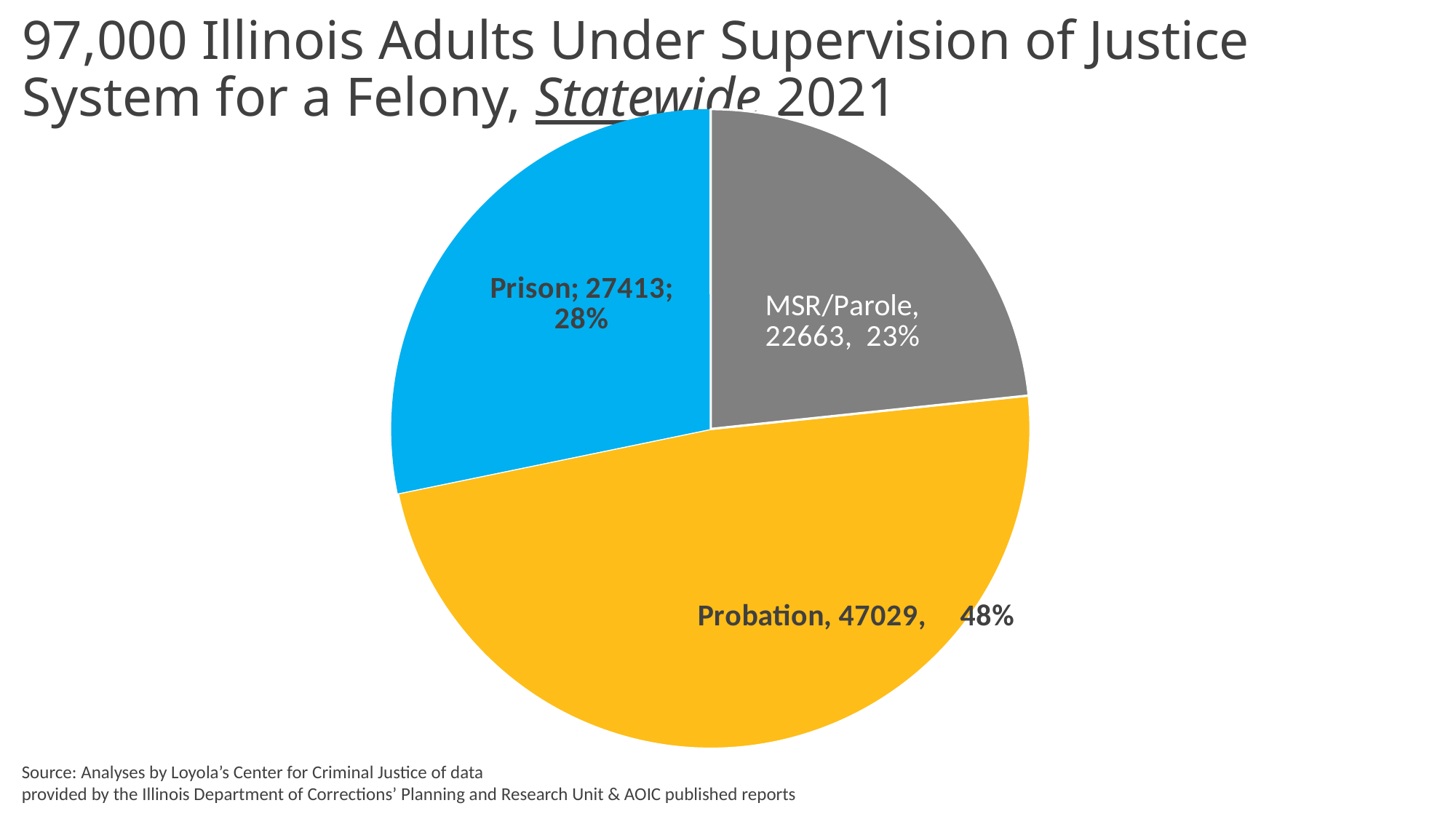
Which category has the smallest slice? MSR/Parole What is the value for MSR/Parole? 22663 What colour is the Probation slice? Yellow What is the value for Probation? 47029 What share of the pie does MSR/Parole represent? 23% Which category has the largest slice? Probation How many slices does the pie chart have? 3 Which is larger, the value for Prison or the value for MSR/Parole? Prison What kind of chart is shown on the slide? Pie chart What is the difference between the Probation and Prison values? 19616 What is the value for Prison? 27413 What share of the pie does Probation represent? 48%